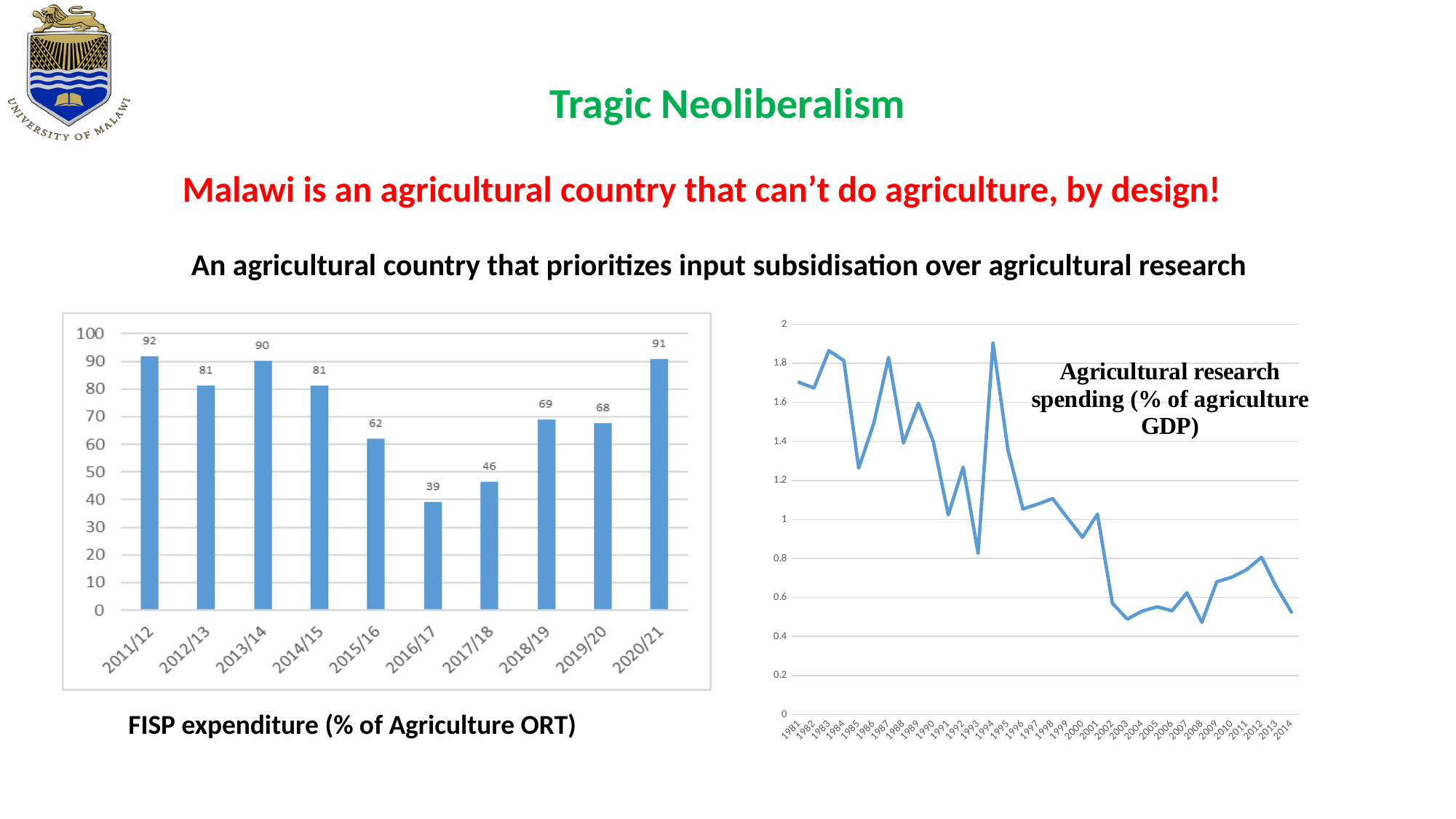
How many years are shown in the FISP expenditure bar chart? 10 In the Agricultural research spending chart, is the value for 1994 greater or less than 1.8? greater In the FISP expenditure chart, what is the difference between the values for 2013/14 and 2015/16? 28 In the FISP expenditure chart, which year has the highest value? 2011/12 In the FISP expenditure chart, what is the value for 2016/17? 39 In the FISP expenditure chart, what is the value for 2020/21? 91 In the Agricultural research spending chart, do values generally rise or fall from 1981 to 2014? fall What kind of chart is the FISP expenditure chart on the left? Bar chart In the FISP expenditure chart, which year has the lowest value? 2016/17 In the FISP expenditure chart, which is larger, the value for 2017/18 or the value for 2018/19? 2018/19 What kind of chart is the Agricultural research spending chart on the right? Line chart In the Agricultural research spending chart, is the value for 2014 greater or less than 0.6? less